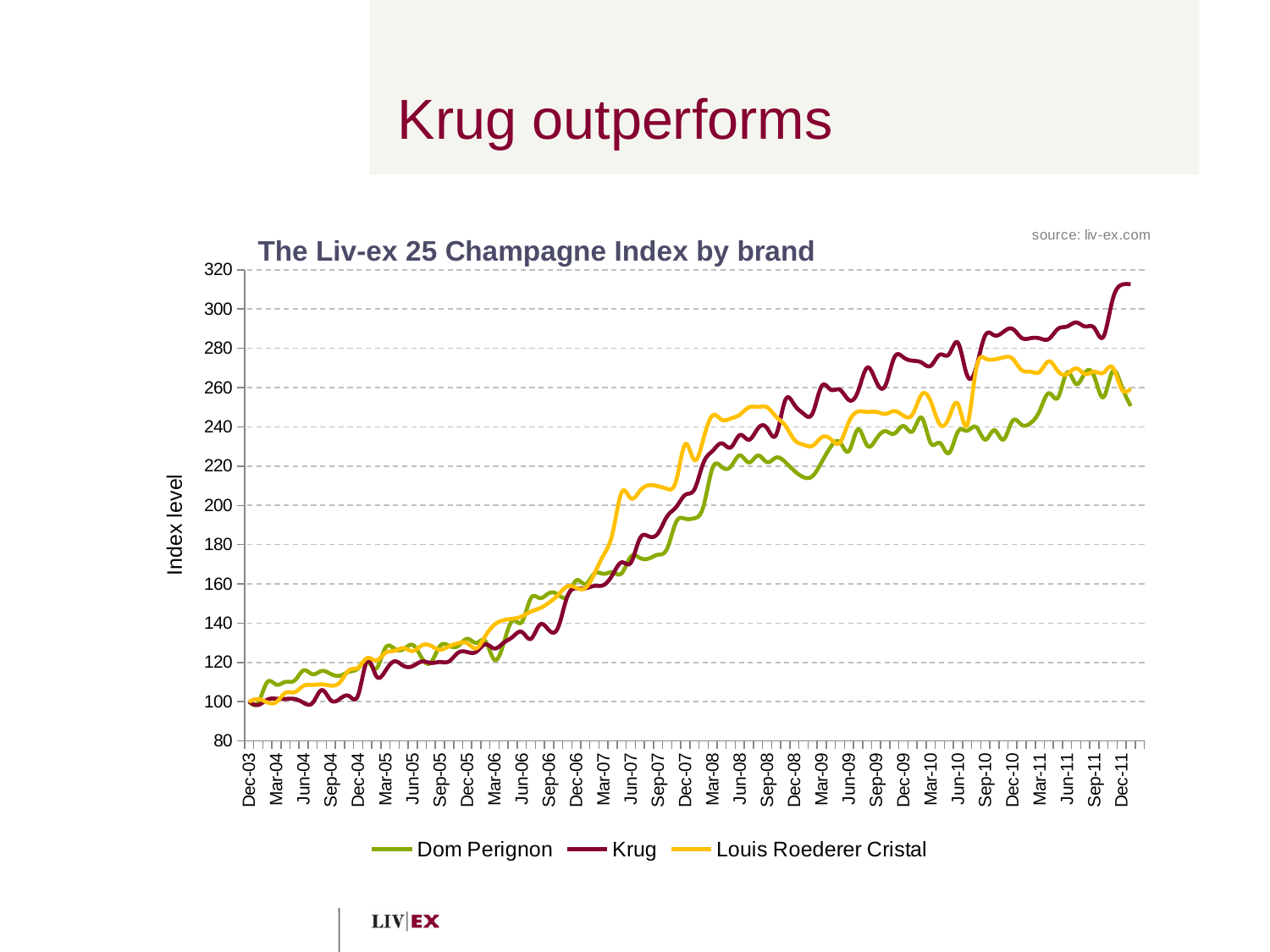
At Mar-08, which is higher: Louis Roederer Cristal or Krug? Louis Roederer Cristal Does the Krug index rise or fall overall from Dec-03 to Dec-11? rise What is the title of the chart? The Liv-ex 25 Champagne Index by brand Is the value for Krug at Dec-11 greater or less than 300? greater How many series does the legend list? 3 Is the value for Louis Roederer Cristal at Jun-07 greater or less than 180? greater Which series has the lowest value at Jun-10? Dom Perignon Which series has the highest value at Dec-11? Krug What is the label on the vertical axis? Index level What kind of chart is shown on the slide? line chart